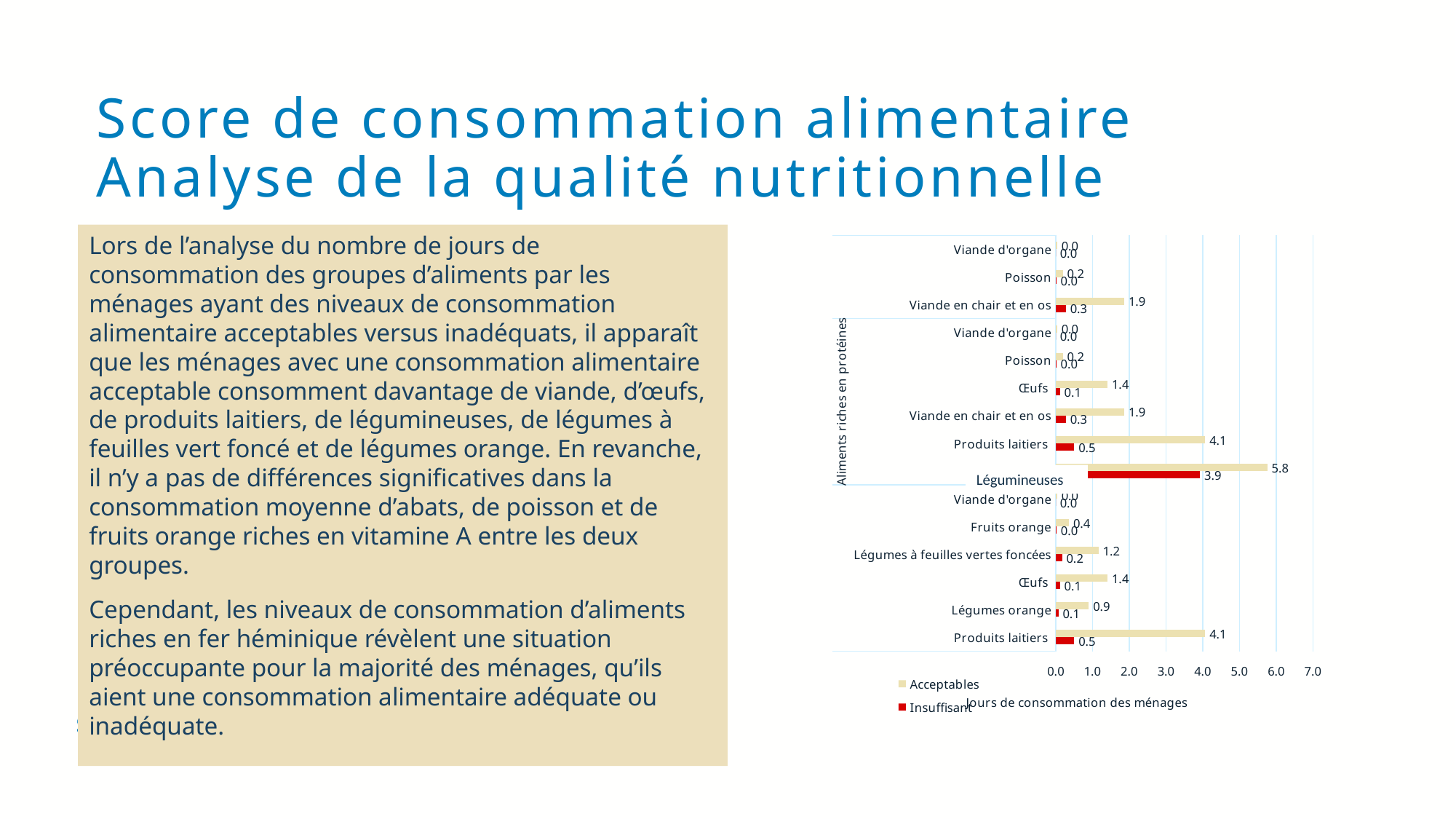
What is the Acceptables value for Produits laitiers? 4.1 What is the Acceptables value for Légumineuses? 5.8 What is the difference between the Acceptables and Insuffisant values for Produits laitiers? 3.6 What is the Insuffisant value for Légumes orange? 0.1 Which category has the highest Acceptables value? Légumineuses What is the title of the horizontal axis of the chart? Jours de consommation des ménages What is the Insuffisant value for Légumineuses? 3.9 What is the difference between the Acceptables and Insuffisant values for Légumineuses? 1.9 How many series does the chart legend list? 2 Which has a larger Acceptables value, Légumes orange or Fruits orange? Légumes orange What is the Acceptables value for Légumes à feuilles vertes foncées? 1.2 What kind of chart is shown on the slide? bar chart